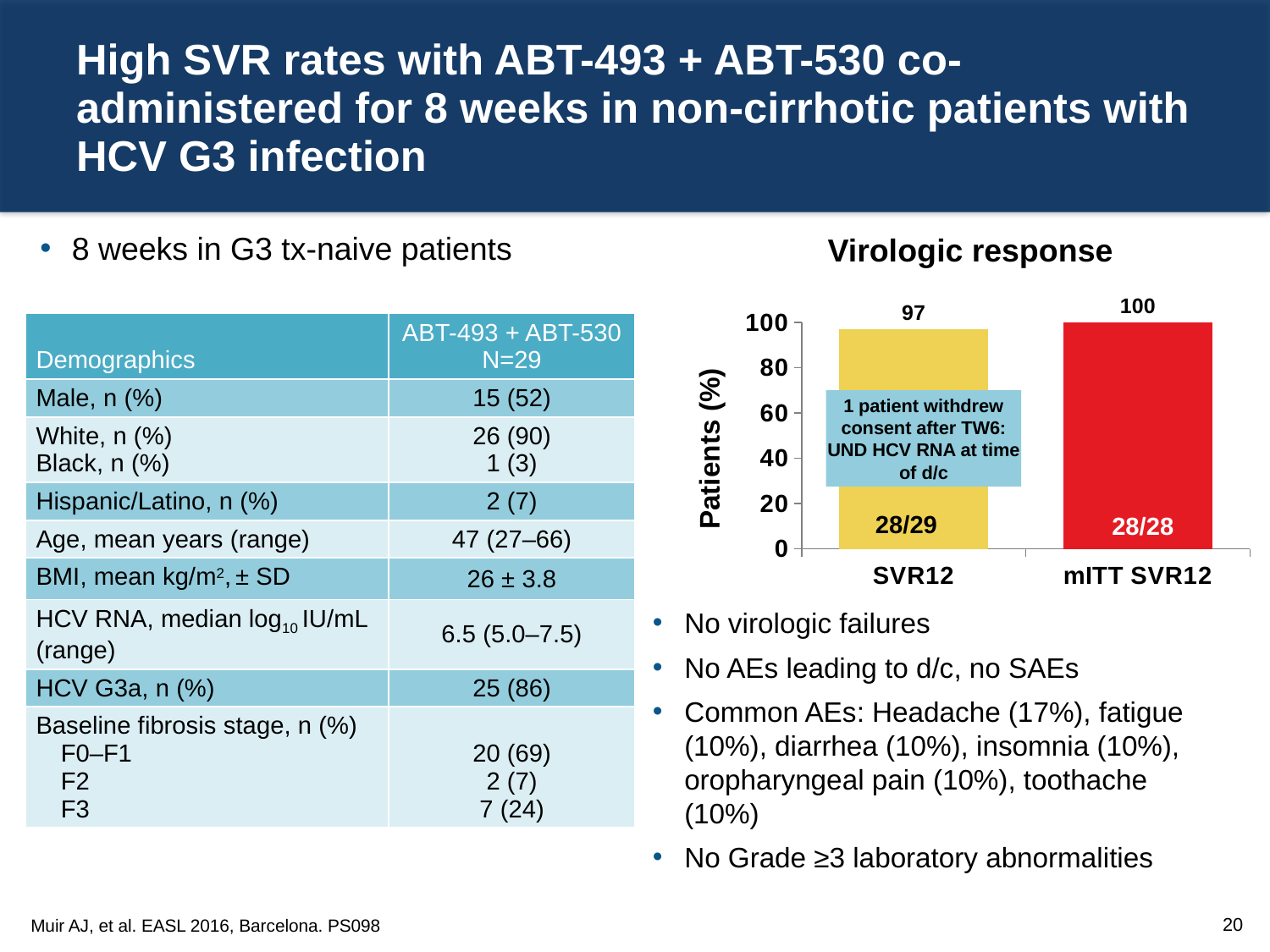
Is the value for SVR12 greater or less than 80 in the Virologic response chart? greater What is the value for mITT SVR12 in the Virologic response chart? 100 What fraction of patients is printed on the mITT SVR12 bar in the Virologic response chart? 28/28 What is the difference between the mITT SVR12 and SVR12 values in the Virologic response chart? 3 Which category has the lowest value in the Virologic response chart? SVR12 What colour is the mITT SVR12 bar in the Virologic response chart? red What fraction of patients is printed on the SVR12 bar in the Virologic response chart? 28/29 What is the y-axis label of the Virologic response chart? Patients (%) What kind of chart is the Virologic response chart? bar chart Which category has the highest value in the Virologic response chart? mITT SVR12 How many categories are shown on the x axis of the Virologic response chart? 2 What is the value for SVR12 in the Virologic response chart? 97